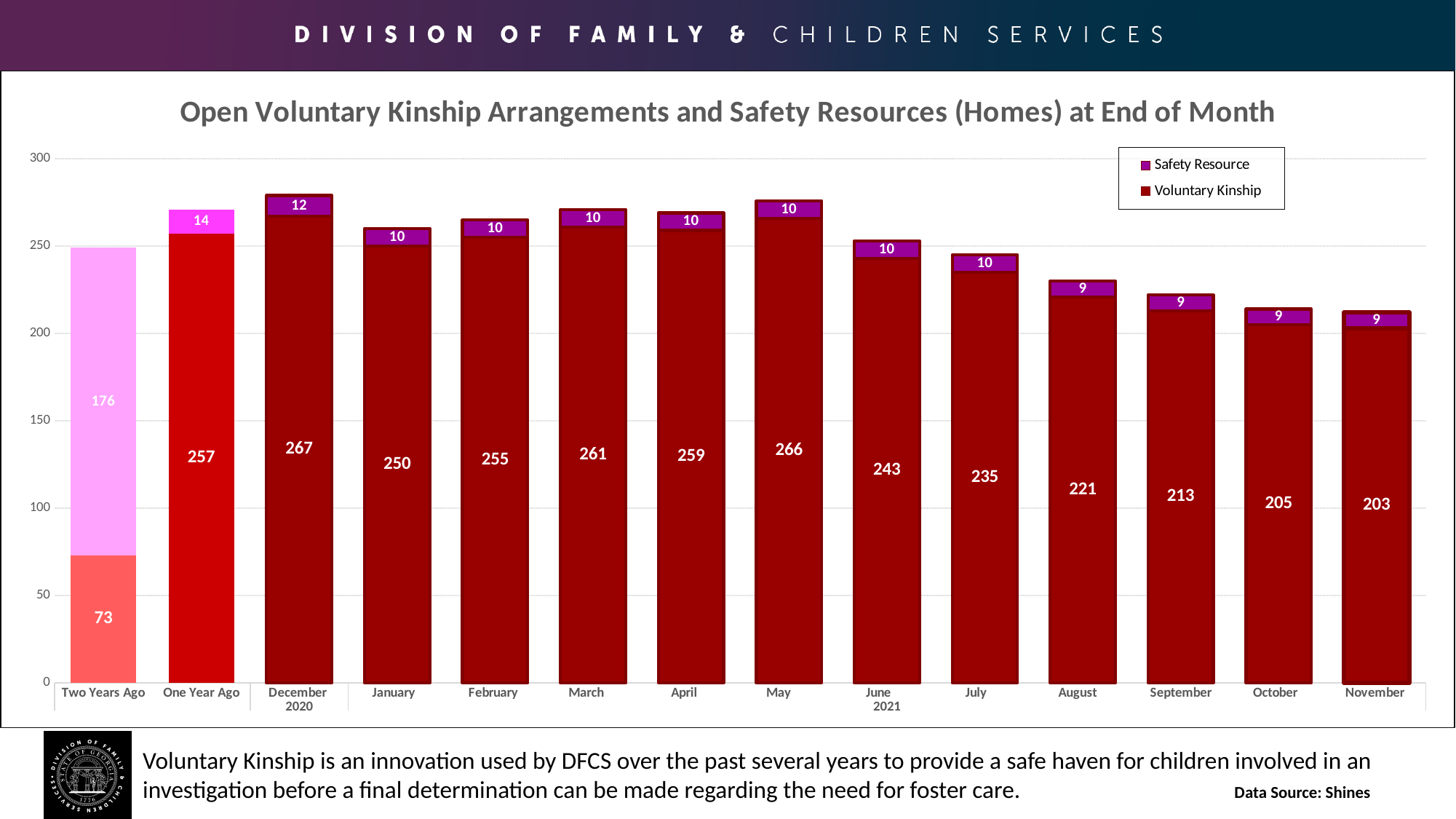
How many series does the legend list? 2 Which is larger, the Voluntary Kinship value for March or for April? March What kind of chart is shown on the slide? Stacked bar chart Which category has the lowest Voluntary Kinship value? Two Years Ago How many categories are shown on the x axis? 14 Which category has the highest Voluntary Kinship value? December 2020 What is the total of the stacked bar for One Year Ago? 271 What is the difference between the Voluntary Kinship values for May and June 2021? 23 What is the Voluntary Kinship value for December 2020? 267 What is the Voluntary Kinship value for November? 203 Do the Voluntary Kinship values rise or fall from May to November? Fall What is the Safety Resource value for Two Years Ago? 176